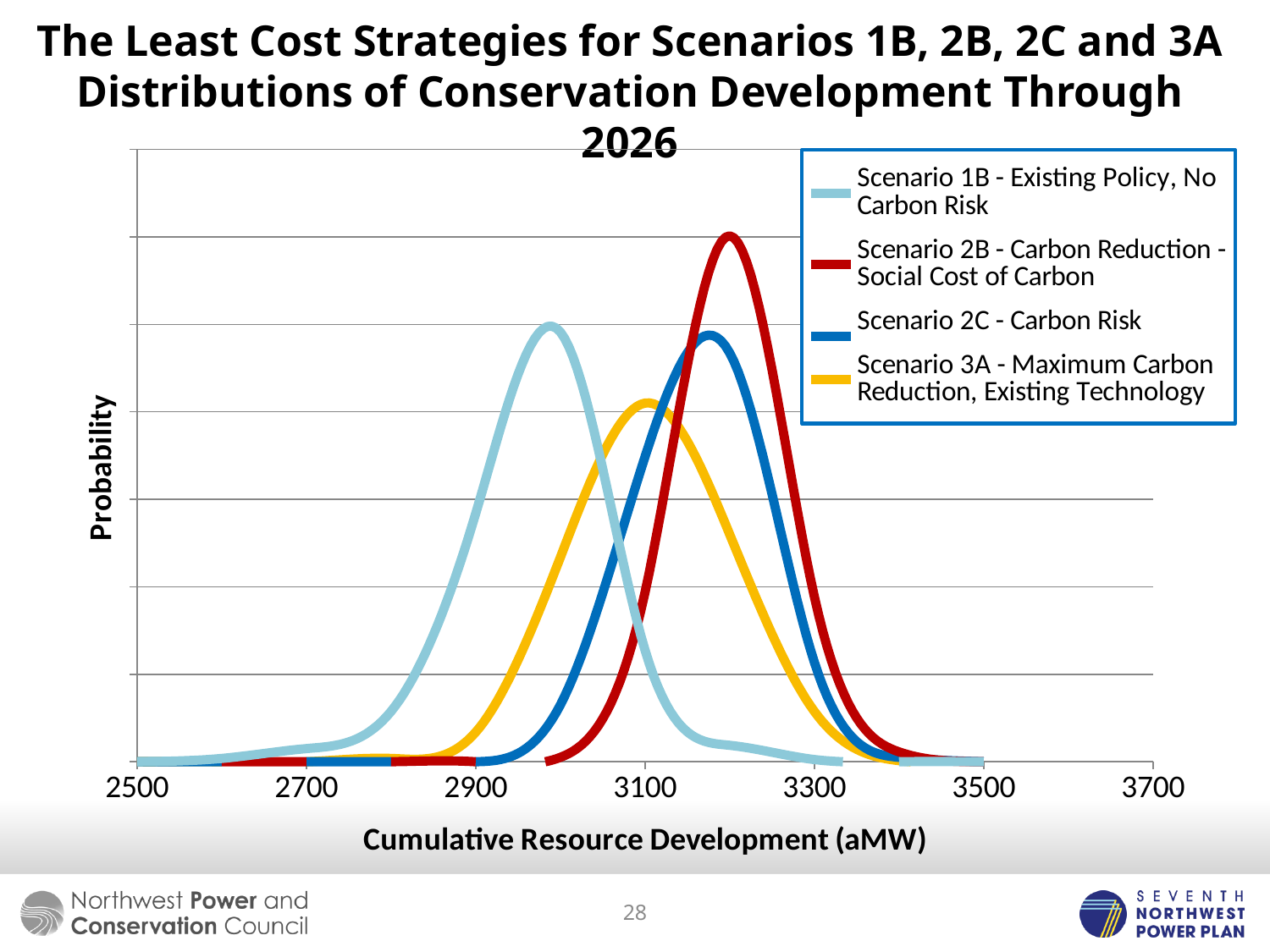
Is the peak of the Scenario 1B curve located at a cumulative resource development greater or less than 3100 aMW? less Is the peak of the Scenario 2C curve located at a cumulative resource development greater or less than 3100 aMW? greater What kind of chart is shown on the slide? Line chart Which peaks higher, the Scenario 2B curve or the Scenario 2C curve? Scenario 2B What is the label of the x axis? Cumulative Resource Development (aMW) Which peaks higher, the Scenario 1B curve or the Scenario 3A curve? Scenario 1B Is the peak of the Scenario 2B curve located at a cumulative resource development greater or less than 3100 aMW? greater How many series does the legend list? 4 Which scenario's distribution reaches the highest peak? Scenario 2B - Carbon Reduction - Social Cost of Carbon Which scenario's distribution peaks furthest to the left along the x axis? Scenario 1B - Existing Policy, No Carbon Risk How many tick labels are shown on the x axis? 7 Which scenario's distribution has the lowest peak? Scenario 3A - Maximum Carbon Reduction, Existing Technology